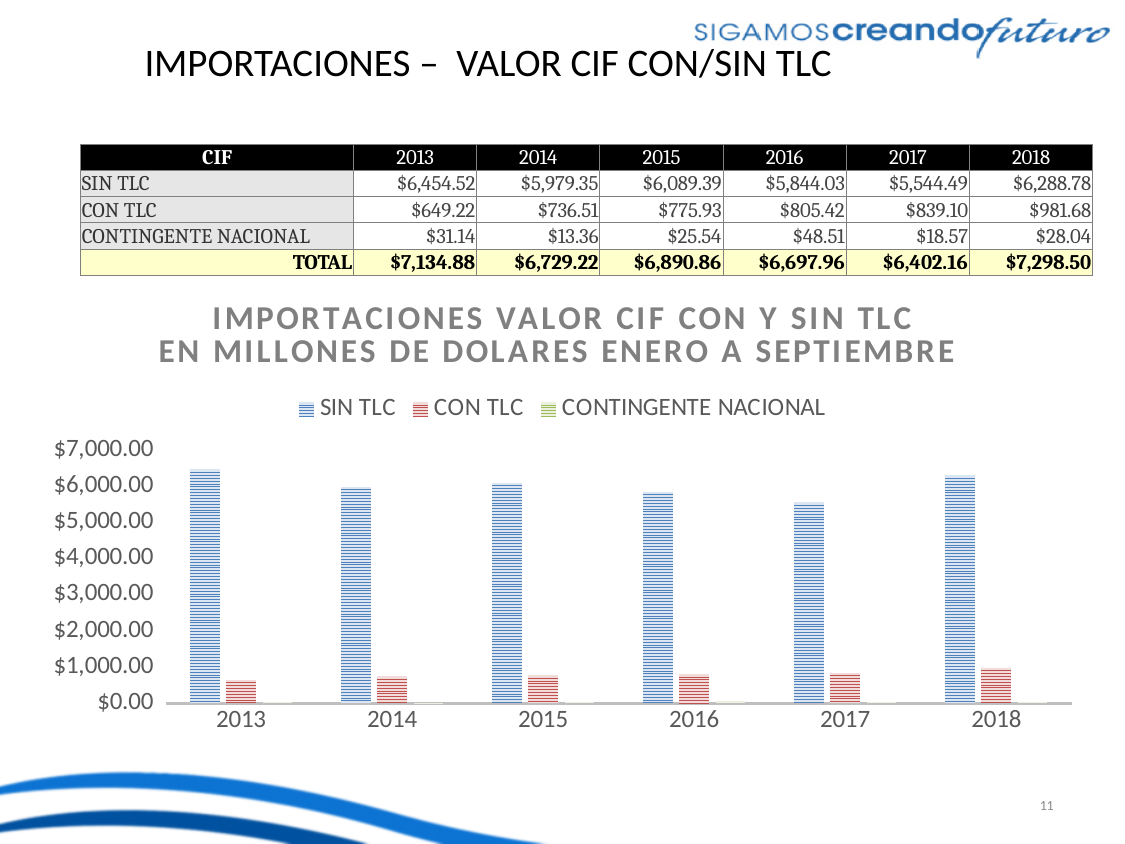
Using the table, what is the difference between the TOTAL for 2018 and the TOTAL for 2017? $896.34 In which year is the SIN TLC bar the shortest? 2017 According to the table, what is the SIN TLC value for 2016? $5,844.03 How many years are shown along the x axis of the chart? 6 Is the CON TLC value for 2013 greater or less than $1,000.00? less According to the table, what is the CON TLC value for 2018? $981.68 Do the CON TLC bars rise or fall from 2013 to 2018? rise Is the SIN TLC value for 2017 greater or less than $6,000.00? less In which year is the SIN TLC bar the tallest? 2013 What kind of chart is shown on the slide? bar chart How many series does the chart legend list? 3 In which year is the CON TLC bar the tallest? 2018